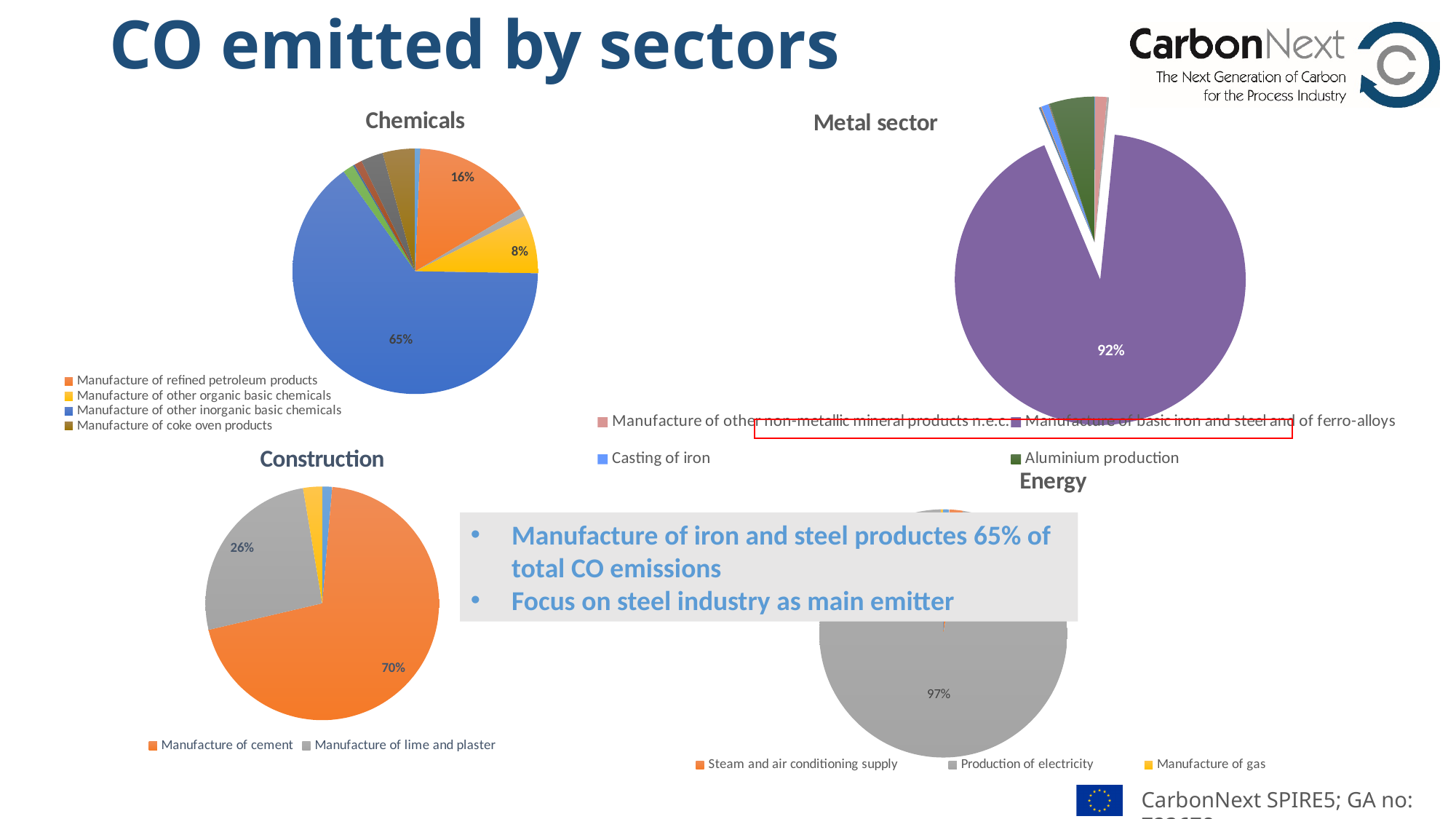
In the Chemicals pie chart, how many percentage points larger is the refined petroleum products slice than the other organic basic chemicals slice? 8 percentage points In the Chemicals pie chart, which category has the largest slice? Manufacture of other inorganic basic chemicals How many entries does the legend of the Metal sector chart list? 4 In the Chemicals pie chart, what share is shown for Manufacture of other organic basic chemicals? 8% In the Construction pie chart, how many percentage points larger is the cement slice than the lime and plaster slice? 44 percentage points In the Construction pie chart, what share is shown for Manufacture of cement? 70% What kind of chart is the Energy chart? Pie chart In the Energy pie chart, what share is shown for Production of electricity? 97% In the Metal sector pie chart, what share is shown for Manufacture of basic iron and steel and of ferro-alloys? 92% In the Construction pie chart, what share is shown for Manufacture of lime and plaster? 26% In the Chemicals pie chart, what share is shown for Manufacture of refined petroleum products? 16% In the Chemicals pie chart, what share is shown for Manufacture of other inorganic basic chemicals? 65%